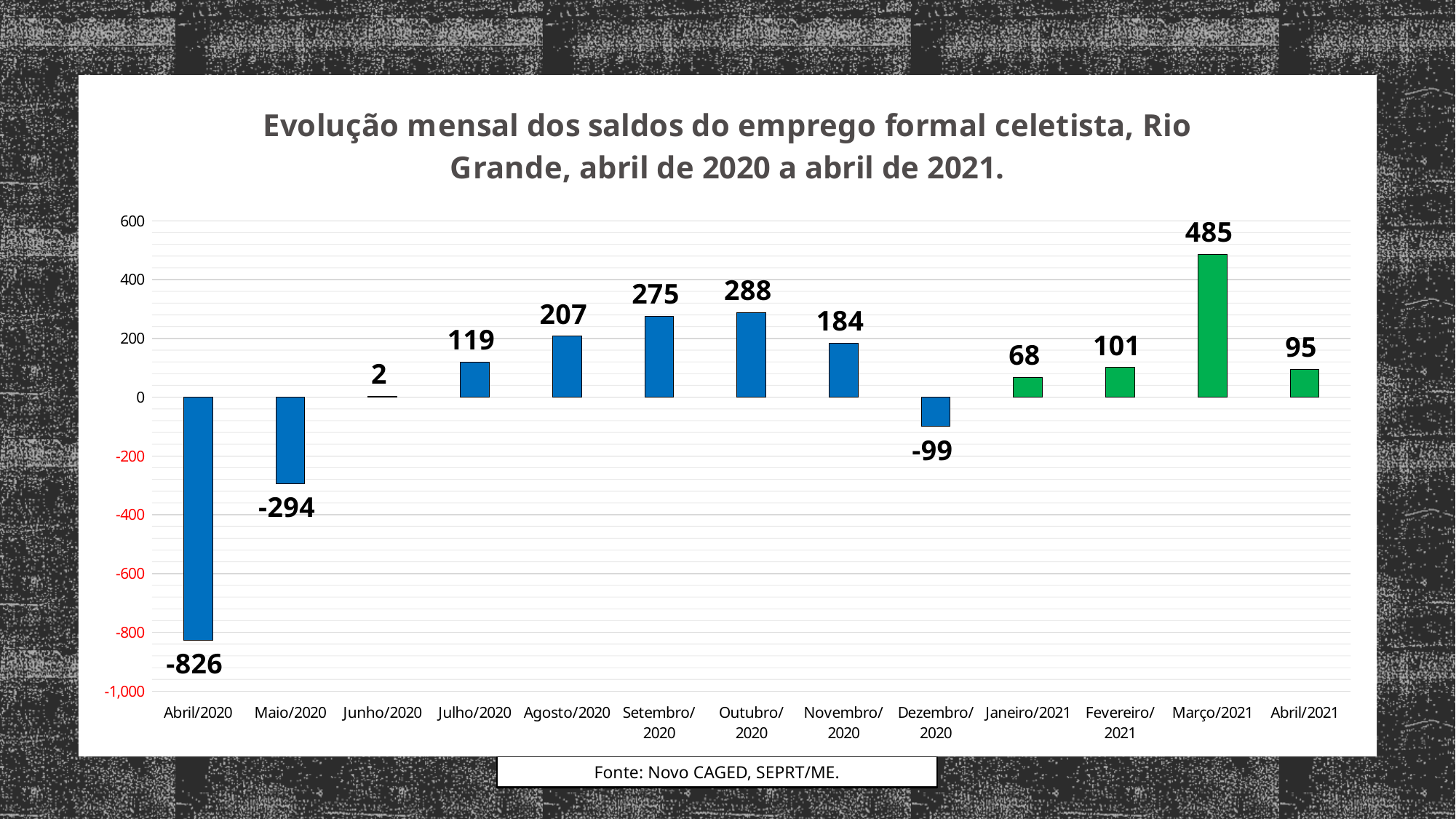
What is the value for Abril/2020? -826 Which month has the lowest value? Abril/2020 What is the source cited below the chart? Novo CAGED, SEPRT/ME. What is the difference between the values for Março/2021 and Abril/2021? 390 What is the value for Março/2021? 485 Which is larger, the value for Setembro/2020 or the value for Novembro/2020? Setembro/2020 What kind of chart is this? bar chart How many months have a negative value? 3 Which month has the highest value? Março/2021 How many months are shown on the x axis? 13 What is the value for Outubro/2020? 288 What is the value for Dezembro/2020? -99